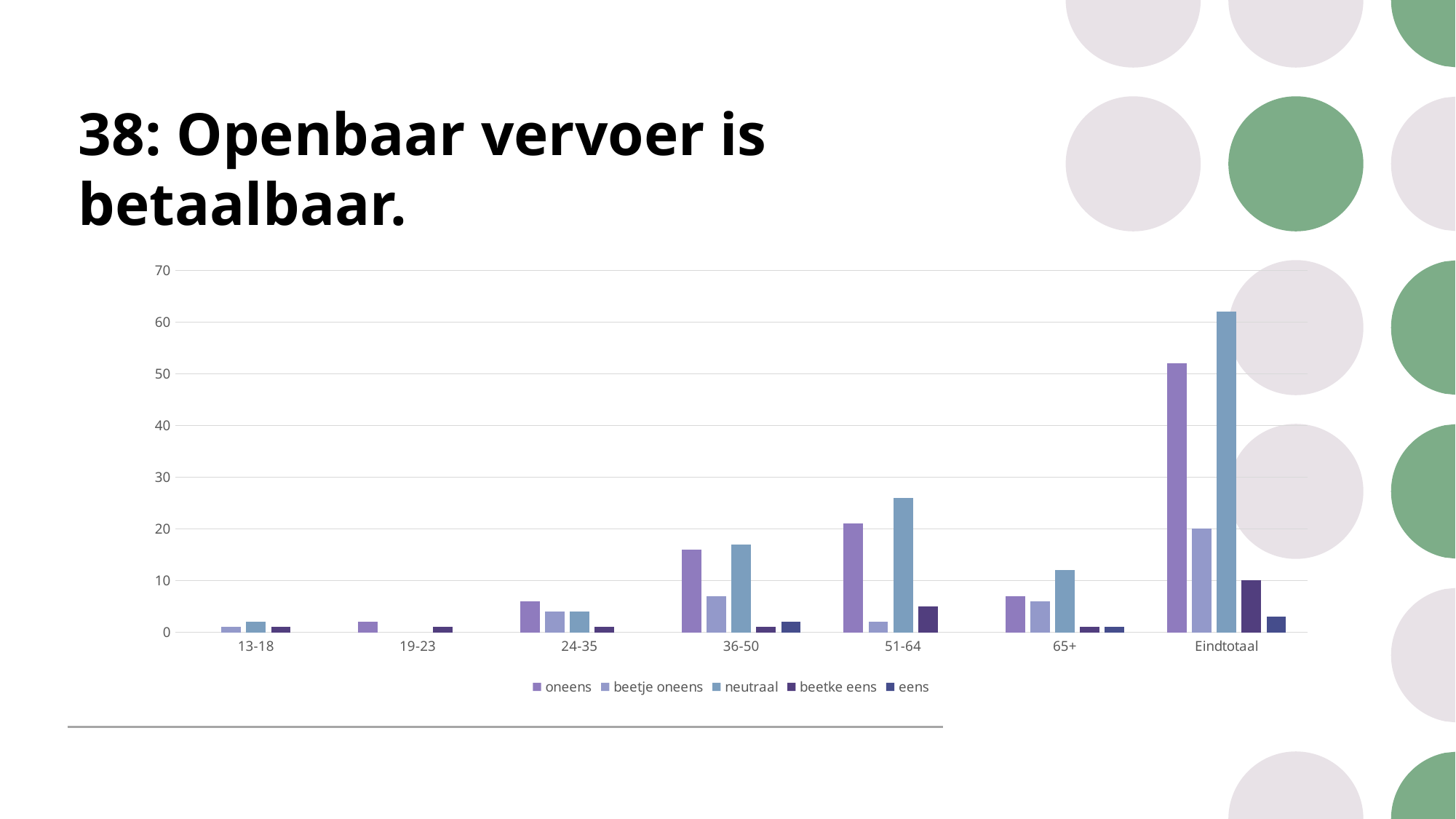
What kind of chart is shown on the slide? bar chart In the 36-50 category, which is larger: the oneens bar or the beetje oneens bar? oneens What is the title of the slide containing the chart? 38: Openbaar vervoer is betaalbaar. Is the value for neutraal in the 51-64 category greater or less than 20? greater In which category is the neutraal bar the highest? Eindtotaal Is the value for oneens in the 36-50 category greater or less than 10? greater Is the value for neutraal in the Eindtotaal category greater or less than 50? greater In the 51-64 category, which is larger: the oneens bar or the neutraal bar? neutraal How many categories are shown on the x axis of the chart? 7 Which series has the tallest bar in the Eindtotaal category? neutraal How many series does the chart's legend list? 5